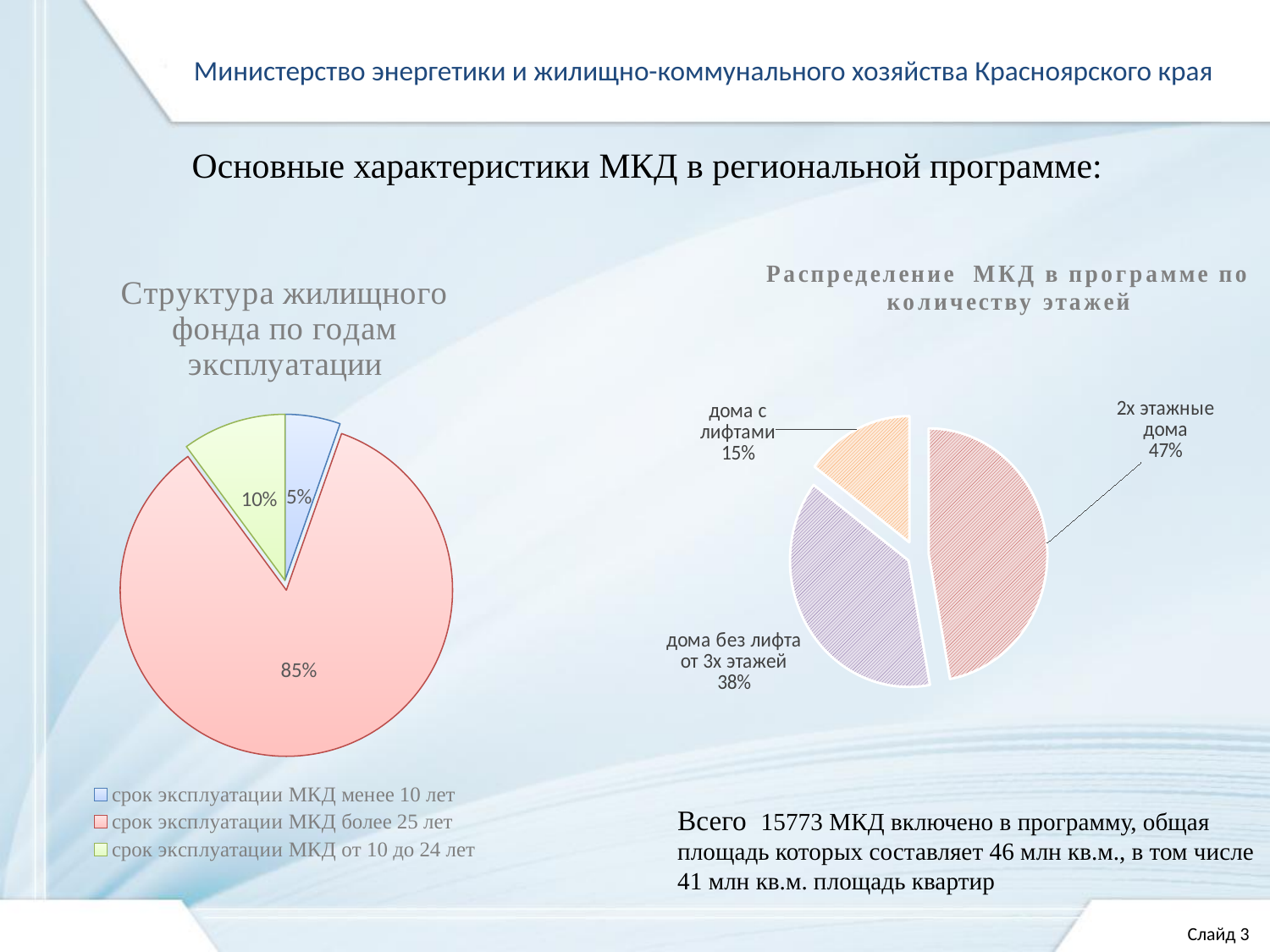
What type of chart is 'Распределение МКД в программе по количеству этажей'? pie chart In the chart 'Структура жилищного фонда по годам эксплуатации', what share is shown for 'срок эксплуатации МКД более 25 лет'? 85% In the chart 'Структура жилищного фонда по годам эксплуатации', which category has the largest slice? срок эксплуатации МКД более 25 лет In the chart 'Распределение МКД в программе по количеству этажей', what share is shown for 'дома с лифтами'? 15% In the chart 'Структура жилищного фонда по годам эксплуатации', which category has the smallest slice? срок эксплуатации МКД менее 10 лет In the chart 'Структура жилищного фонда по годам эксплуатации', how many entries does the legend list? 3 In the chart 'Распределение МКД в программе по количеству этажей', what is the difference between the shares of '2х этажные дома' and 'дома с лифтами'? 32% In the chart 'Распределение МКД в программе по количеству этажей', what share is shown for 'дома без лифта от 3х этажей'? 38% In the chart 'Распределение МКД в программе по количеству этажей', what share is shown for '2х этажные дома'? 47% In the chart 'Структура жилищного фонда по годам эксплуатации', what share is shown for 'срок эксплуатации МКД от 10 до 24 лет'? 10% In the chart 'Структура жилищного фонда по годам эксплуатации', what share is shown for 'срок эксплуатации МКД менее 10 лет'? 5% In the chart 'Распределение МКД в программе по количеству этажей', how many slices does the pie have? 3